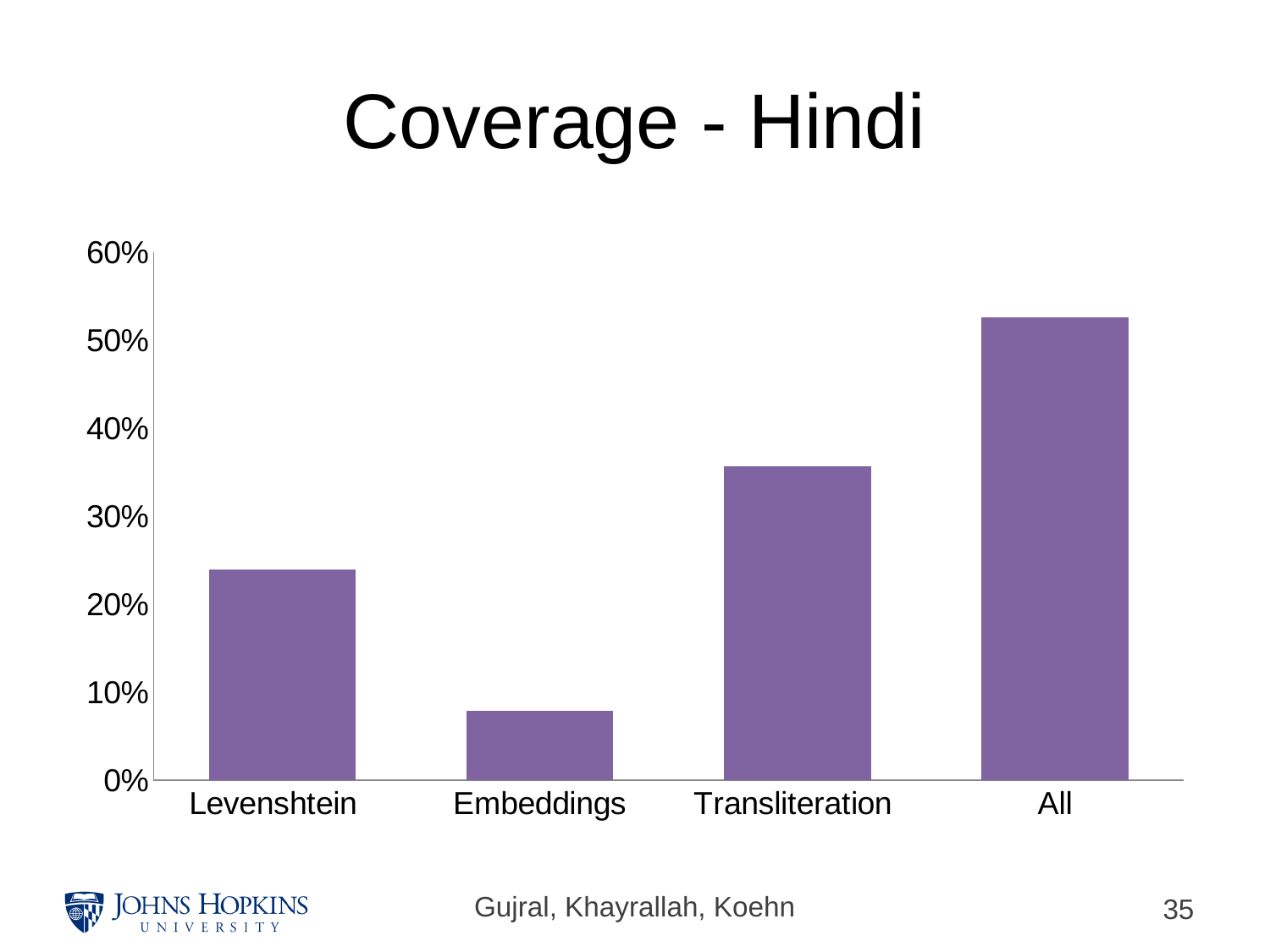
What is the title of the chart? Coverage - Hindi Which has a higher coverage, Levenshtein or Transliteration? Transliteration Which category has the highest coverage? All Is the value for Embeddings greater or less than 10%? less What type of chart is shown on the slide? bar chart Which has a lower coverage, Embeddings or Levenshtein? Embeddings Is the value for Levenshtein greater or less than 20%? greater What is the maximum value shown on the y axis? 60% Which category has the lowest coverage? Embeddings Is the value for All greater or less than 50%? greater How many categories are shown on the x axis? 4